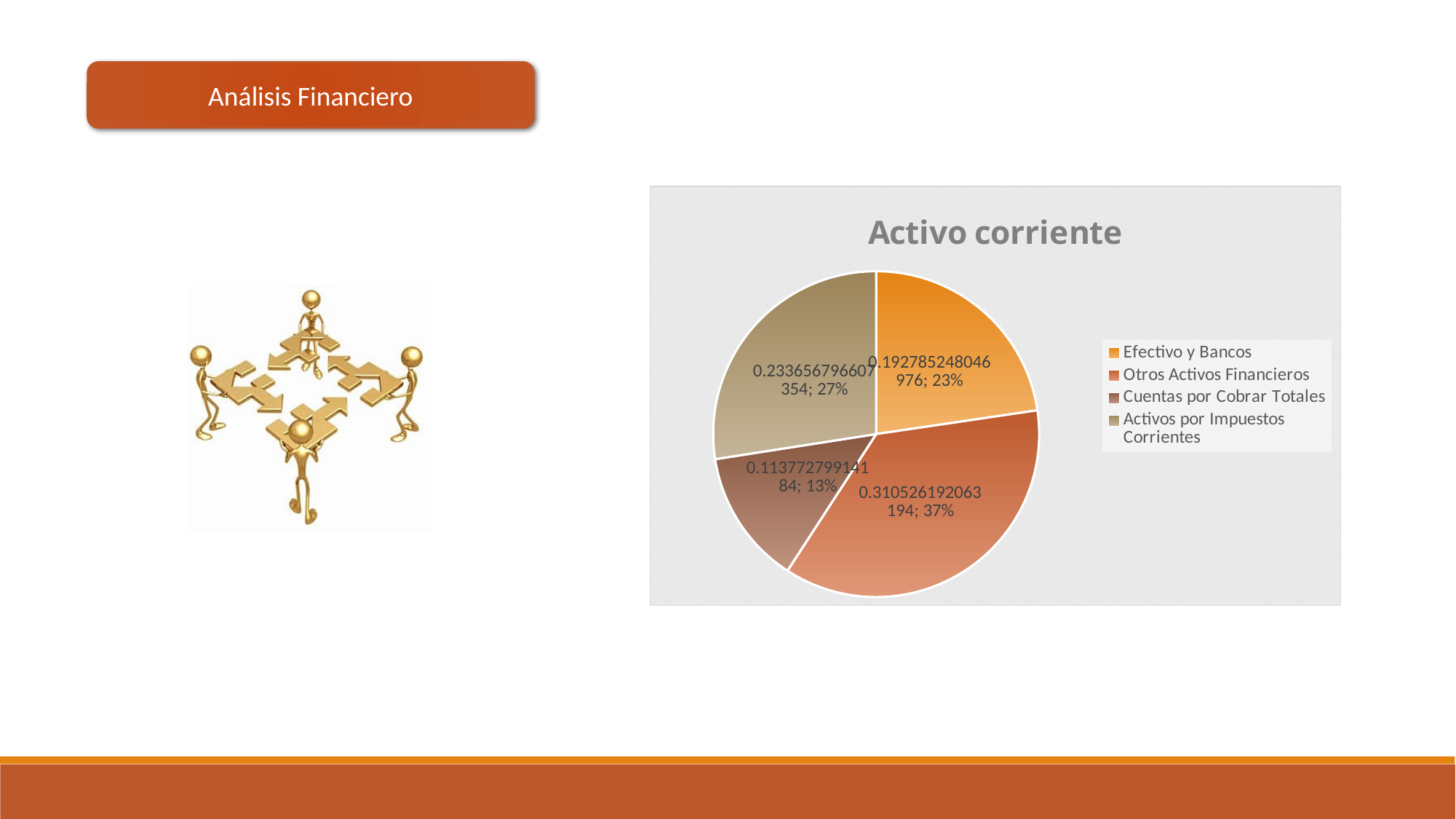
What is the title of the chart? Activo corriente How many entries does the legend of the pie chart list? 4 What type of chart is shown under the title "Activo corriente"? Pie chart What is the difference in percentage points between the shares of Otros Activos Financieros and Cuentas por Cobrar Totales? 24 percentage points Which has a larger share: Efectivo y Bancos or Activos por Impuestos Corrientes? Activos por Impuestos Corrientes Which category has the smallest slice in the pie chart? Cuentas por Cobrar Totales What percentage share does Activos por Impuestos Corrientes have in the pie chart? 27% What percentage share does Efectivo y Bancos have in the pie chart? 23% How many slices does the pie chart have? 4 Which category has the largest slice in the pie chart? Otros Activos Financieros What percentage share does Cuentas por Cobrar Totales have in the pie chart? 13%